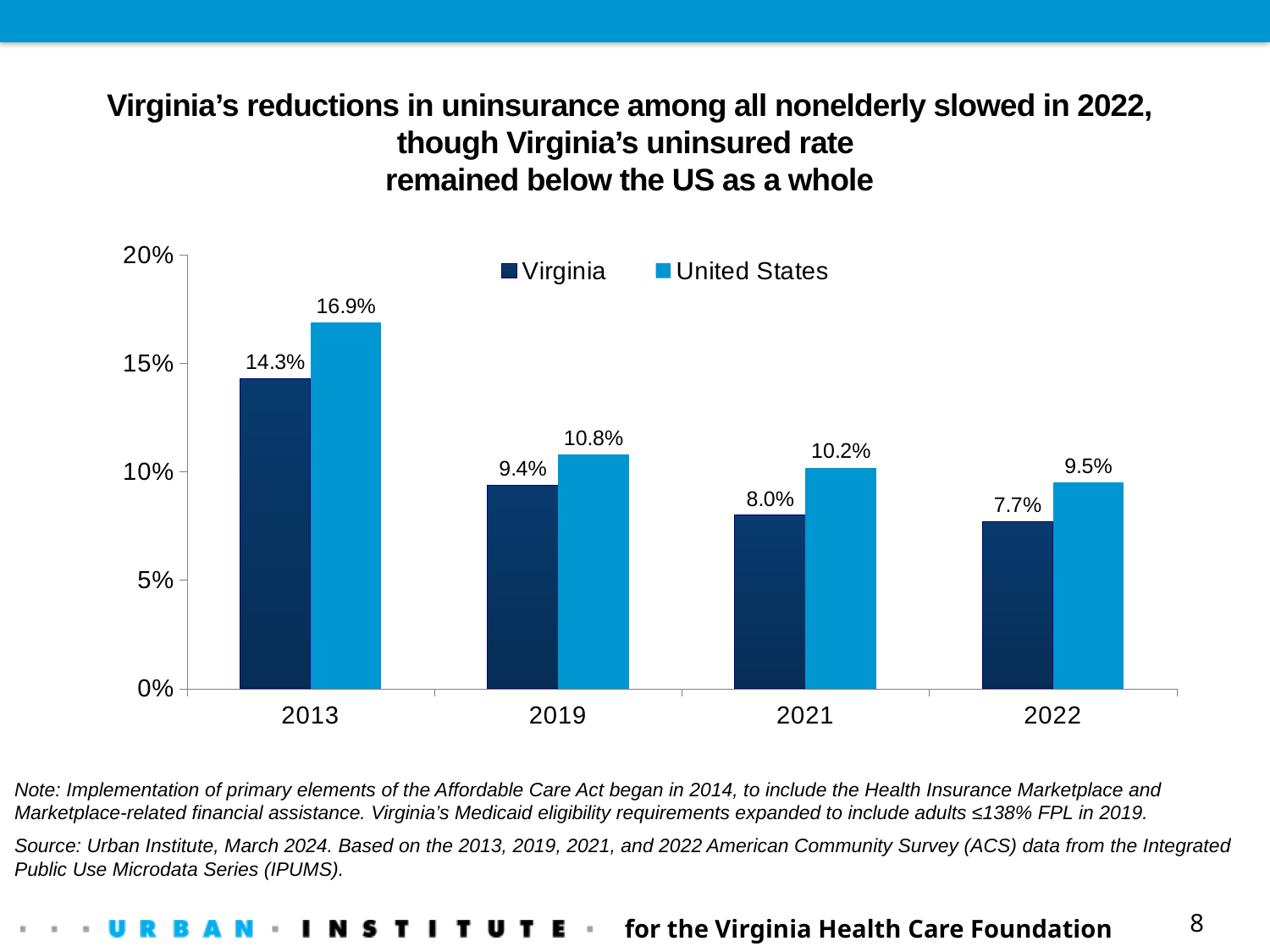
What was the United States uninsured rate in 2022? 9.5% What was Virginia's uninsured rate in 2013? 14.3% How many years are shown on the x axis? 4 How many series does the legend list? 2 What was Virginia's uninsured rate in 2021? 8.0% What kind of chart is shown on the slide? Bar chart In which year was Virginia's uninsured rate lowest? 2022 What is the difference between the United States and Virginia uninsured rates in 2019? 1.4% In which year was the United States uninsured rate highest? 2013 Is the United States uninsured rate in 2013 greater or less than 15%? greater By how much did Virginia's uninsured rate fall from 2013 to 2022? 6.6% Which was higher in 2021, Virginia's uninsured rate or the United States uninsured rate? United States